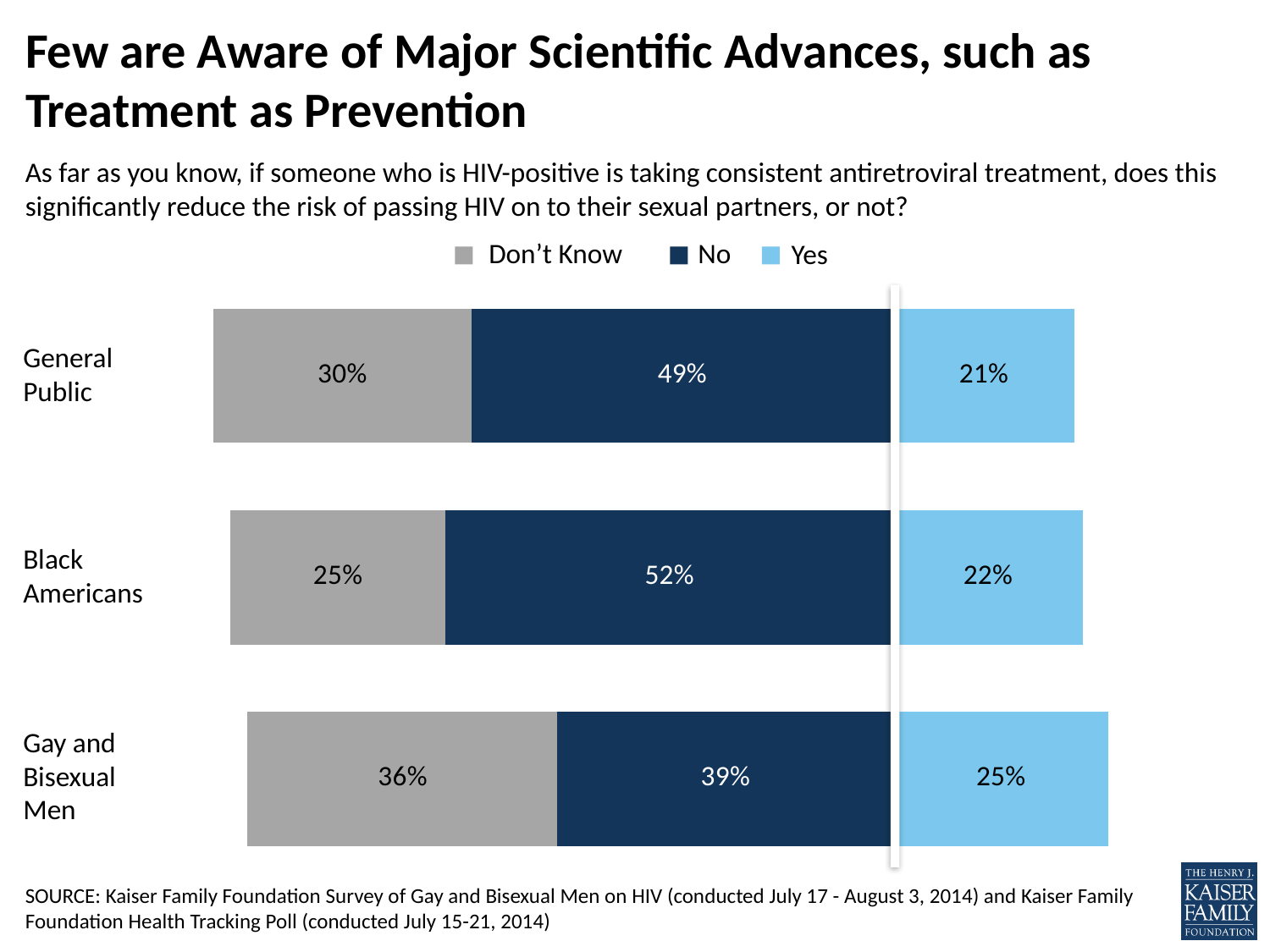
How many groups are shown in the chart? 3 How many series does the legend list? 3 What percentage of Gay and Bisexual Men answered "Don't Know"? 36% What percentage of the General Public answered "Yes"? 21% What is the difference between the "No" percentage for Black Americans and for Gay and Bisexual Men? 13 percentage points What percentage of Black Americans answered "No"? 52% Which group has the lowest "No" percentage? Gay and Bisexual Men Which group has the highest "Yes" percentage? Gay and Bisexual Men What is the total of the three segments for the Black Americans bar? 99% Which colour represents the "Yes" response in the chart? Light blue Which is larger: the "Don't Know" share for the General Public or for Black Americans? General Public What kind of chart is shown on the slide? Stacked bar chart